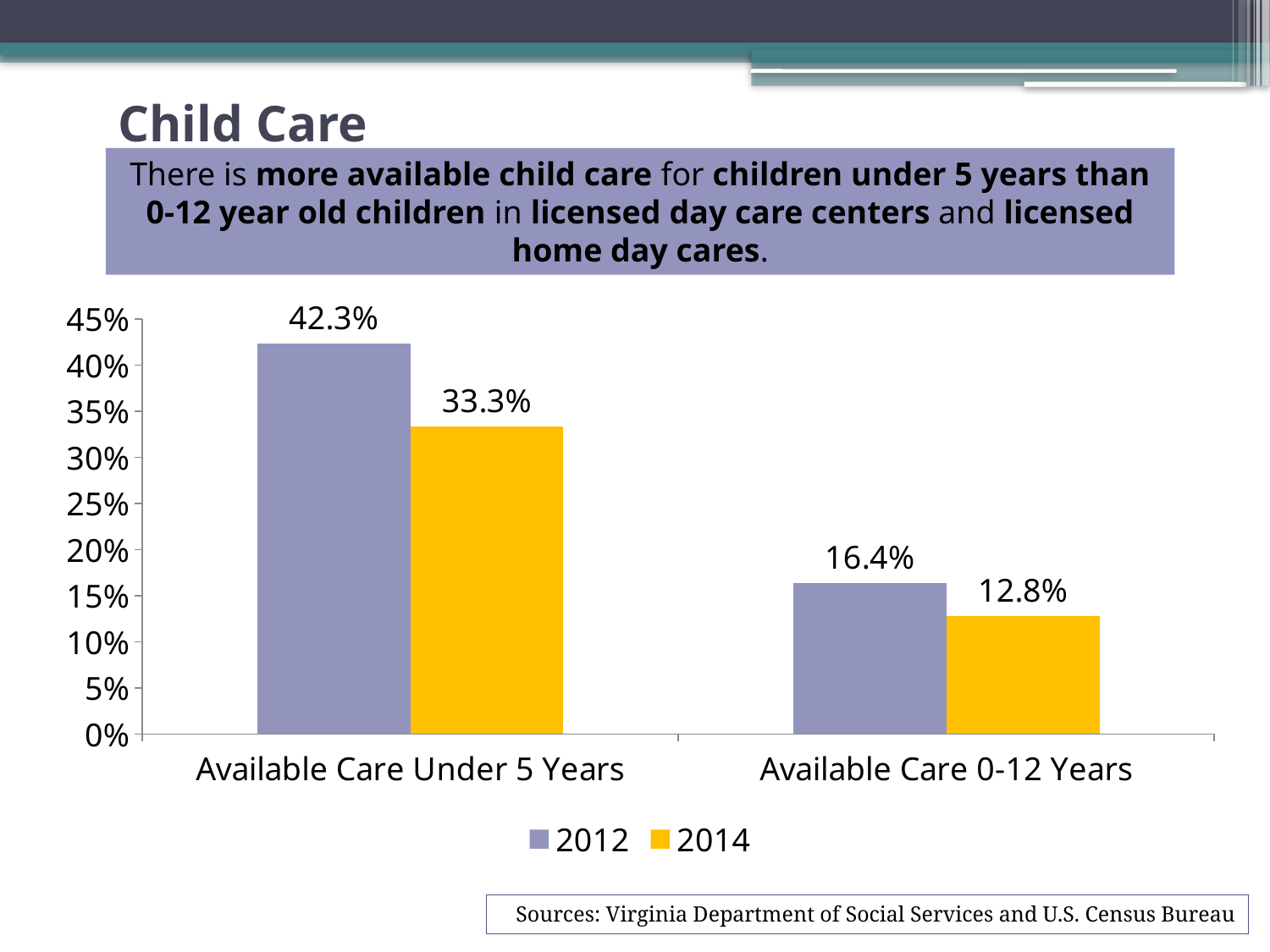
What kind of chart is shown on the slide? Bar chart Which category has the lowest 2014 value? Available Care 0-12 Years What is the 2012 value for Available Care 0-12 Years? 16.4% Which category has the highest 2012 value? Available Care Under 5 Years What is the 2014 value for Available Care 0-12 Years? 12.8% What is the difference between the 2012 and 2014 values for Available Care 0-12 Years? 3.6% What is the 2014 value for Available Care Under 5 Years? 33.3% What is the 2012 value for Available Care Under 5 Years? 42.3% Which is larger: the 2014 value for Available Care Under 5 Years or the 2012 value for Available Care 0-12 Years? 2014 value for Available Care Under 5 Years What is the difference between the 2012 and 2014 values for Available Care Under 5 Years? 9.0% How many categories are shown on the x axis? 2 How many series does the legend list? 2